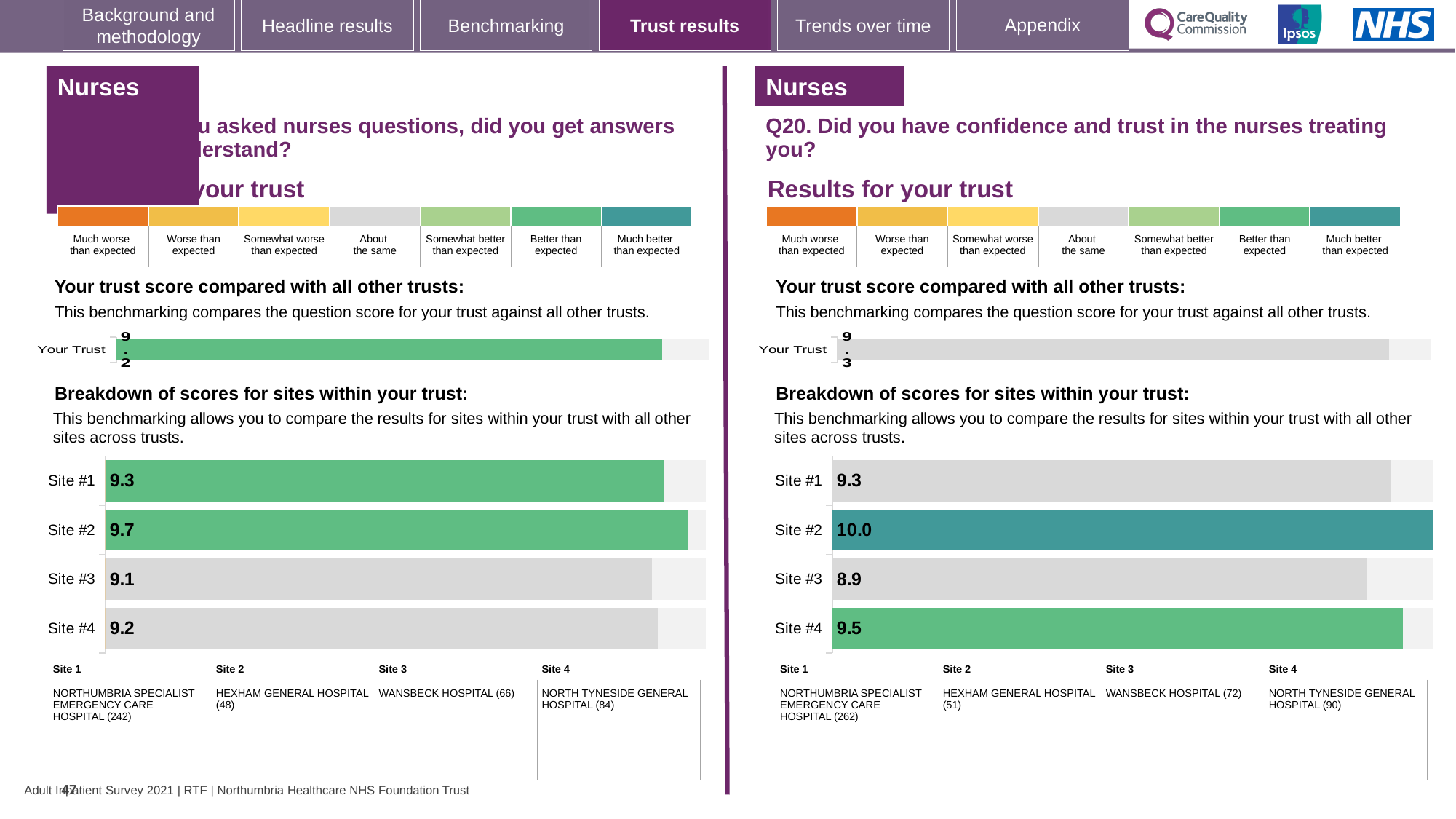
In the site breakdown chart on the right-hand side of the slide (Q20), which site has the highest score? Site #2 In the site breakdown chart on the left-hand side of the slide, which site has the lowest score? Site #3 In the site breakdown chart on the right-hand side of the slide (Q20), what is the score for Site #3? 8.9 What type of chart is used for the site breakdown on the right-hand side of the slide (Q20)? Bar chart In the site breakdown chart on the right-hand side of the slide (Q20), what is the difference between the scores for Site #2 and Site #3? 1.1 In the 'Your trust score compared with all other trusts' chart on the left-hand side of the slide, what is the score for Your Trust? 9.2 In the site breakdown chart on the left-hand side of the slide, what is the score for Site #2? 9.7 How many sites are shown in the site breakdown chart on the left-hand side of the slide? 4 In the 'Your trust score compared with all other trusts' chart on the right-hand side of the slide (Q20), what is the score for Your Trust? 9.3 In the site breakdown chart on the left-hand side of the slide, what is the difference between the scores for Site #2 and Site #1? 0.4 In the site breakdown chart on the right-hand side of the slide (Q20), what colour is the bar for Site #2? Teal (Much better than expected) In the site breakdown chart on the right-hand side of the slide (Q20), which is larger: the score for Site #1 or Site #4? Site #4